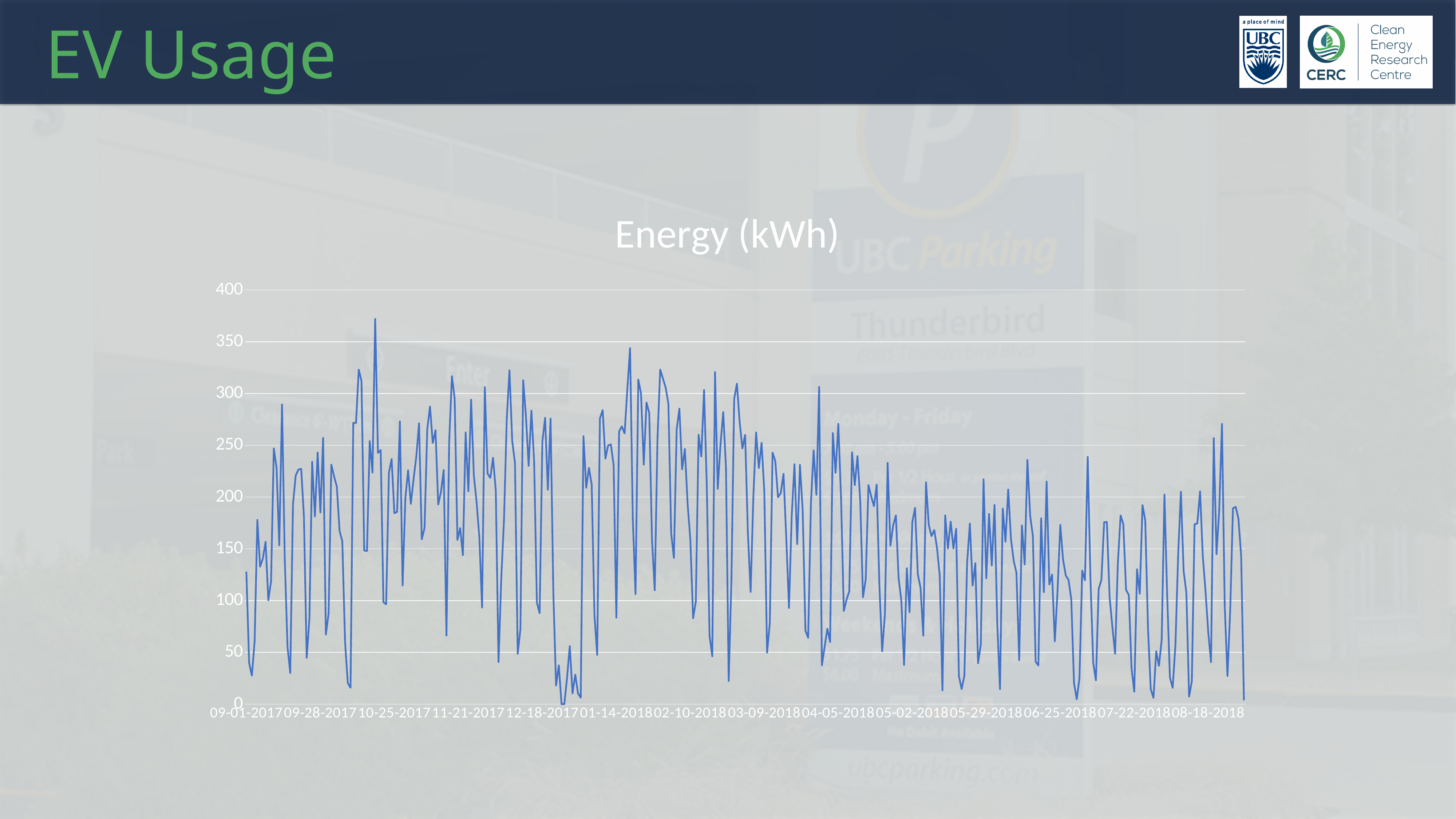
Is the highest peak of the line located before or after the 01-14-2018 tick? before Is the value at the first point (09-01-2017) greater or less than 100? greater What kind of chart is shown on the slide? line chart What is the first date label on the x axis? 09-01-2017 Does any point on the line exceed 400? No What is the highest value shown on the y axis of the chart? 400 Do the peak values of the line generally rise or fall from late 2017 to summer 2018? fall What is the interval between consecutive y-axis tick labels? 50 How many date labels are shown along the x axis? 14 What is the last date label on the x axis? 08-18-2018 Is the highest peak of the line greater or less than 350? greater What is the title of the chart? Energy (kWh)